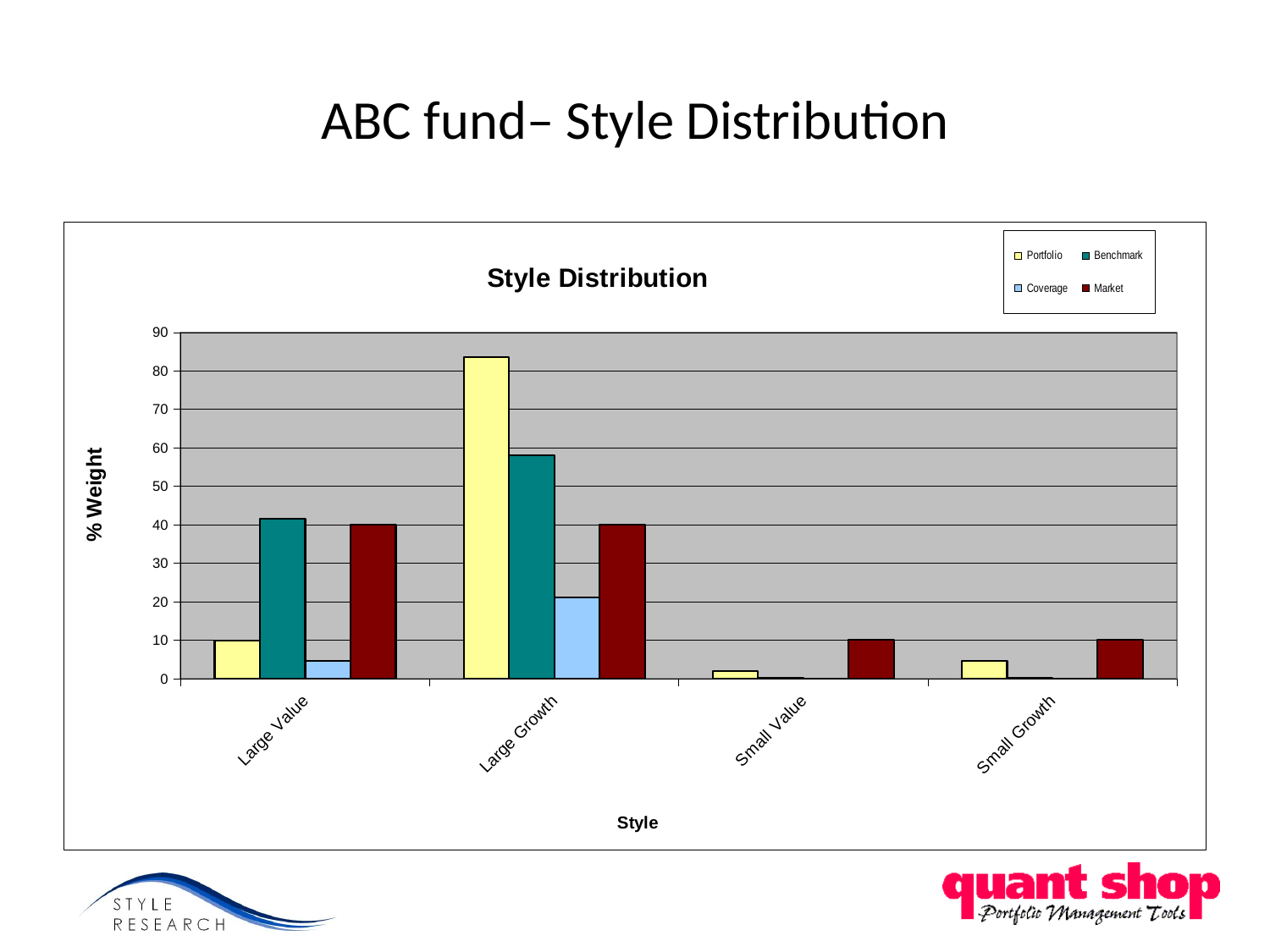
Is the Benchmark value for Large Growth greater or less than 50? greater Is the Portfolio value for Large Growth greater or less than 80? greater Which category has the highest Portfolio value? Large Growth What is the label of the y axis? % Weight For Large Value, which is larger, the Portfolio value or the Benchmark value? Benchmark For Large Growth, which is larger, the Portfolio value or the Market value? Portfolio How many series does the legend list? 4 How many style categories are shown on the x axis? 4 What type of chart is shown on the slide? bar chart What is the title of the chart? Style Distribution Is the Coverage value for Large Growth greater or less than 30? less Which category has the highest Benchmark value? Large Growth